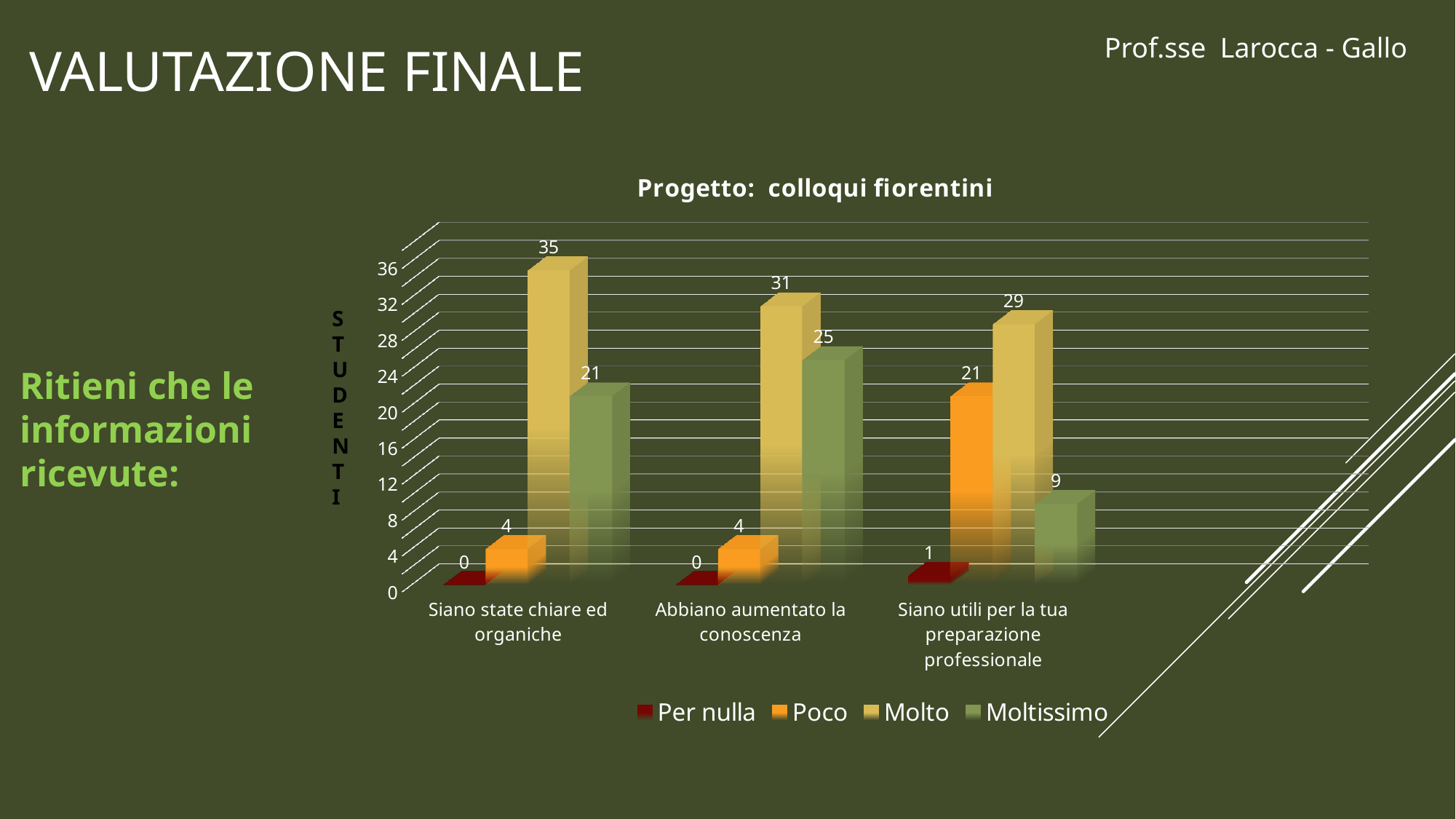
Which category has the lowest value for the "Moltissimo" series? Siano utili per la tua preparazione professionale What is the difference between the "Molto" and "Moltissimo" values in the category "Siano state chiare ed organiche"? 14 What is the value for "Per nulla" in the category "Siano utili per la tua preparazione professionale"? 1 What is the value for "Molto" in the category "Siano state chiare ed organiche"? 35 What is the value for "Poco" in the category "Siano utili per la tua preparazione professionale"? 21 Which category has the highest value for the "Molto" series? Siano state chiare ed organiche What is the title of the chart? Progetto: colloqui fiorentini Which is larger: the "Molto" value for "Abbiano aumentato la conoscenza" or the "Molto" value for "Siano utili per la tua preparazione professionale"? Abbiano aumentato la conoscenza How many series does the chart legend list? 4 What is the value for "Moltissimo" in the category "Abbiano aumentato la conoscenza"? 25 How many categories are shown on the x axis of the chart? 3 What kind of chart is shown on the slide? Bar chart